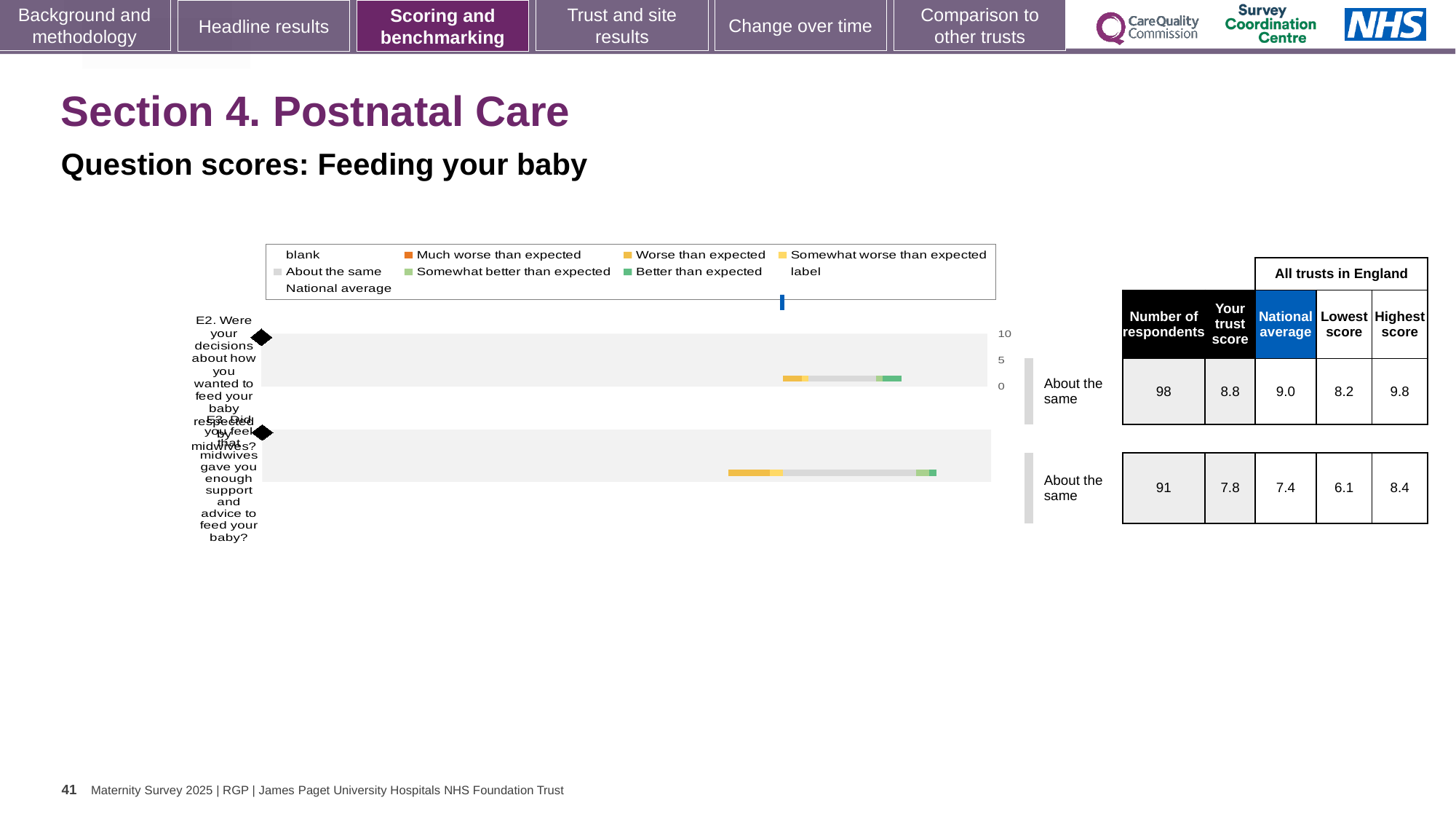
What benchmark category is shown next to the bar for question E3? About the same What is the difference between the highest score and the lowest score for question E2? 1.6 What is the national average for question E2? 9.0 What is the lowest score among all trusts in England for question E3? 6.1 What kind of chart is shown on the slide? bar chart How many respondents answered question E2? 98 What is the trust score for question E3 (midwives gave you enough support and advice to feed your baby)? 7.8 Which question has the higher trust score, E2 or E3? E2 How many questions (categories) are plotted in the chart? 2 What is the trust score for question E2 (decisions about how you wanted to feed your baby respected by midwives)? 8.8 What is the national average for question E3? 7.4 How many respondents answered question E3? 91